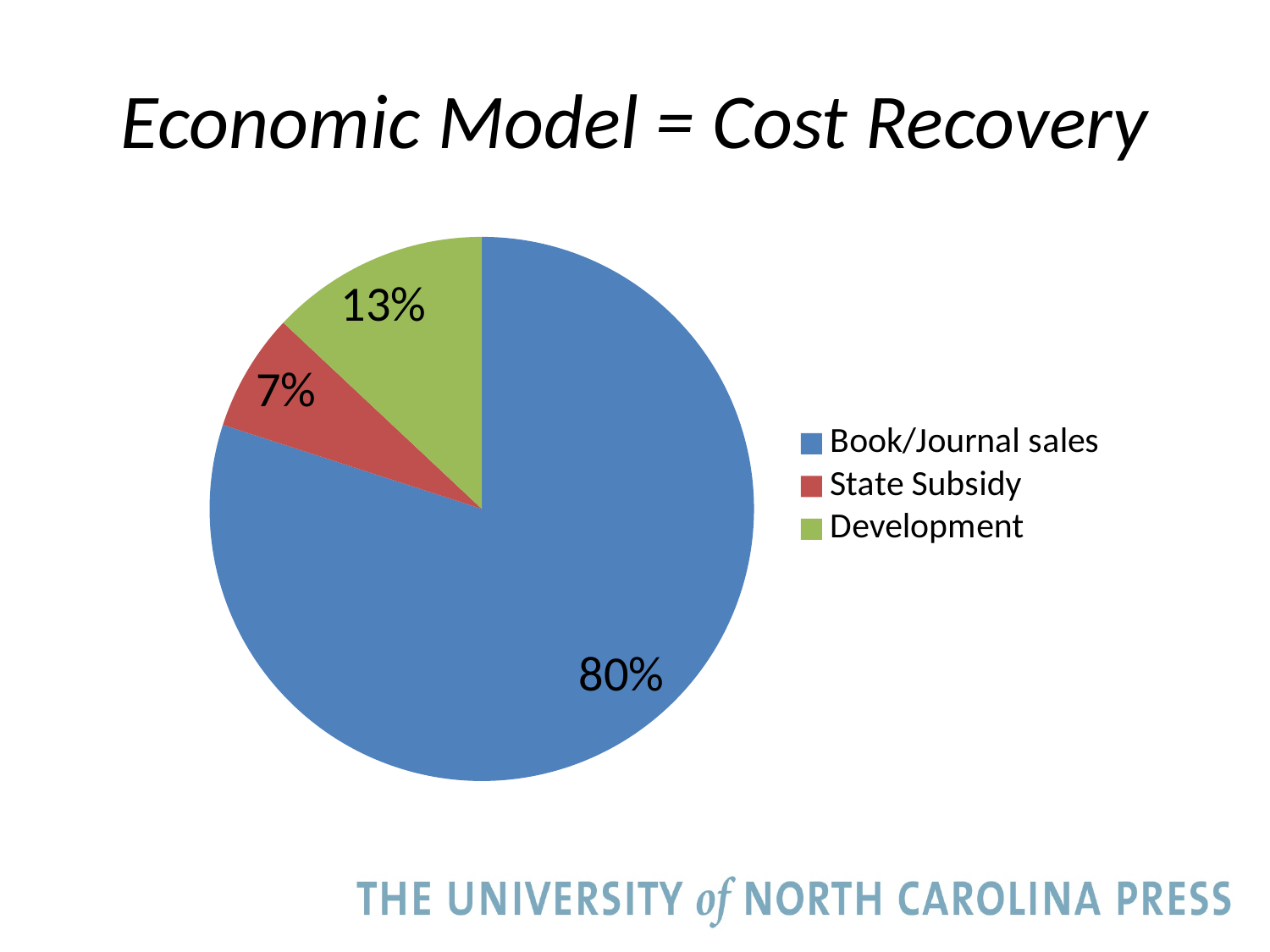
Which category has the largest slice of the pie? Book/Journal sales What share of the pie is Book/Journal sales? 80% What share of the pie is State Subsidy? 7% What share of the pie is Development? 13% How many slices does the pie chart have? 3 Which is larger, the Development slice or the State Subsidy slice? Development What colour is the Book/Journal sales slice? blue Which category has the smallest slice of the pie? State Subsidy What is the difference in percentage points between Development and State Subsidy? 6 What is the difference in percentage points between Book/Journal sales and Development? 67 What is the title of the slide containing the pie chart? Economic Model = Cost Recovery What kind of chart is shown on the slide? pie chart